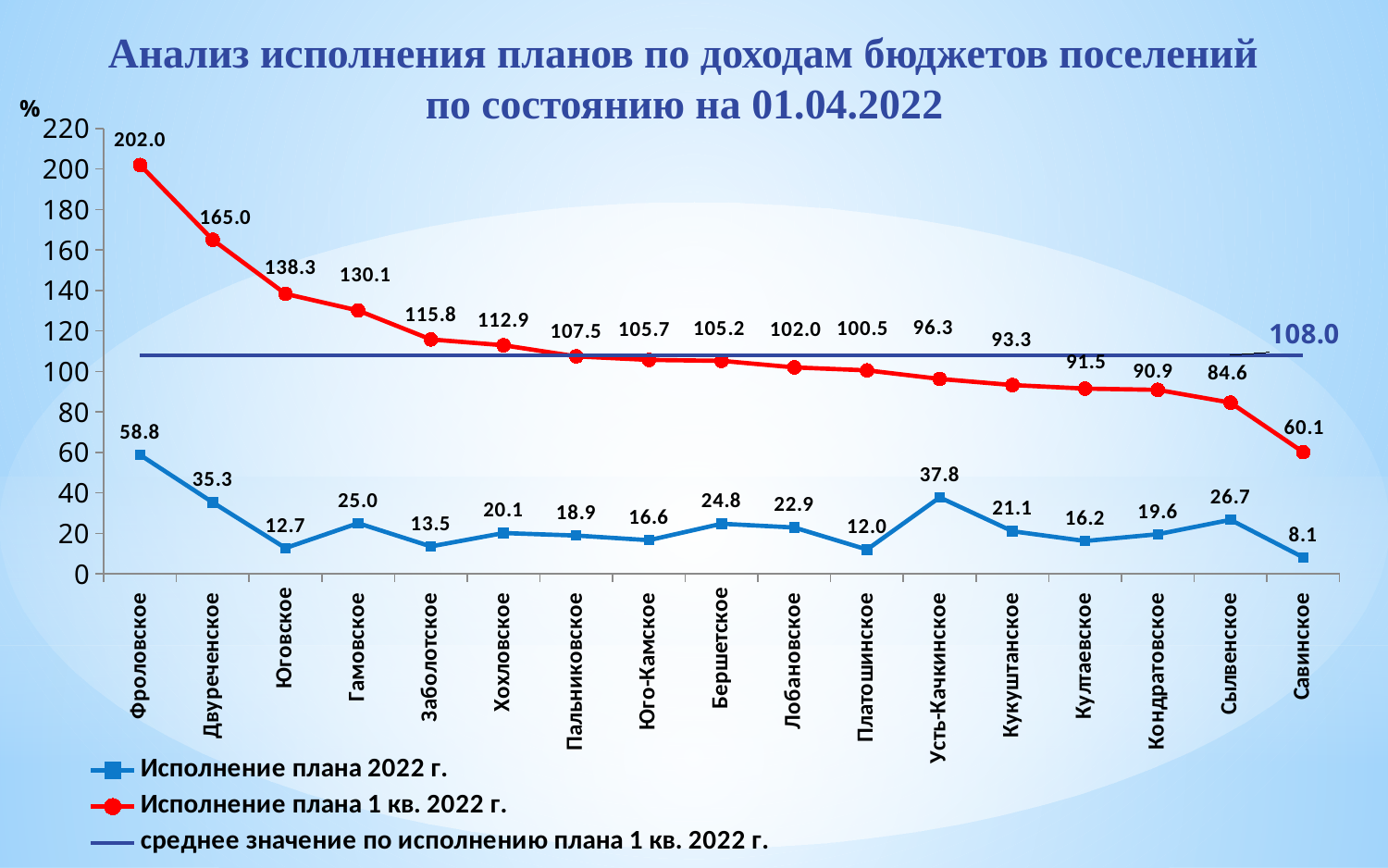
What is the value of 'Исполнение плана 2022 г.' for Усть-Качкинское? 37.8 How many settlements (categories) are shown on the x axis? 17 Does the 'Исполнение плана 1 кв. 2022 г.' series generally rise or fall from left to right along the x axis? fall What is the value of 'Исполнение плана 1 кв. 2022 г.' for Фроловское? 202.0 Which settlement has the lowest value for 'Исполнение плана 1 кв. 2022 г.'? Савинское What is the value of the line 'среднее значение по исполнению плана 1 кв. 2022 г.'? 108.0 Which settlement has the highest value for 'Исполнение плана 2022 г.'? Фроловское What is the title of the chart? Анализ исполнения планов по доходам бюджетов поселений по состоянию на 01.04.2022 Which is larger for 'Исполнение плана 2022 г.': Гамовское or Бершетское? Гамовское How many series does the legend list? 3 What is the difference between the 'Исполнение плана 1 кв. 2022 г.' values for Двуреченское and Юговское? 26.7 What type of chart is shown on the slide? line chart